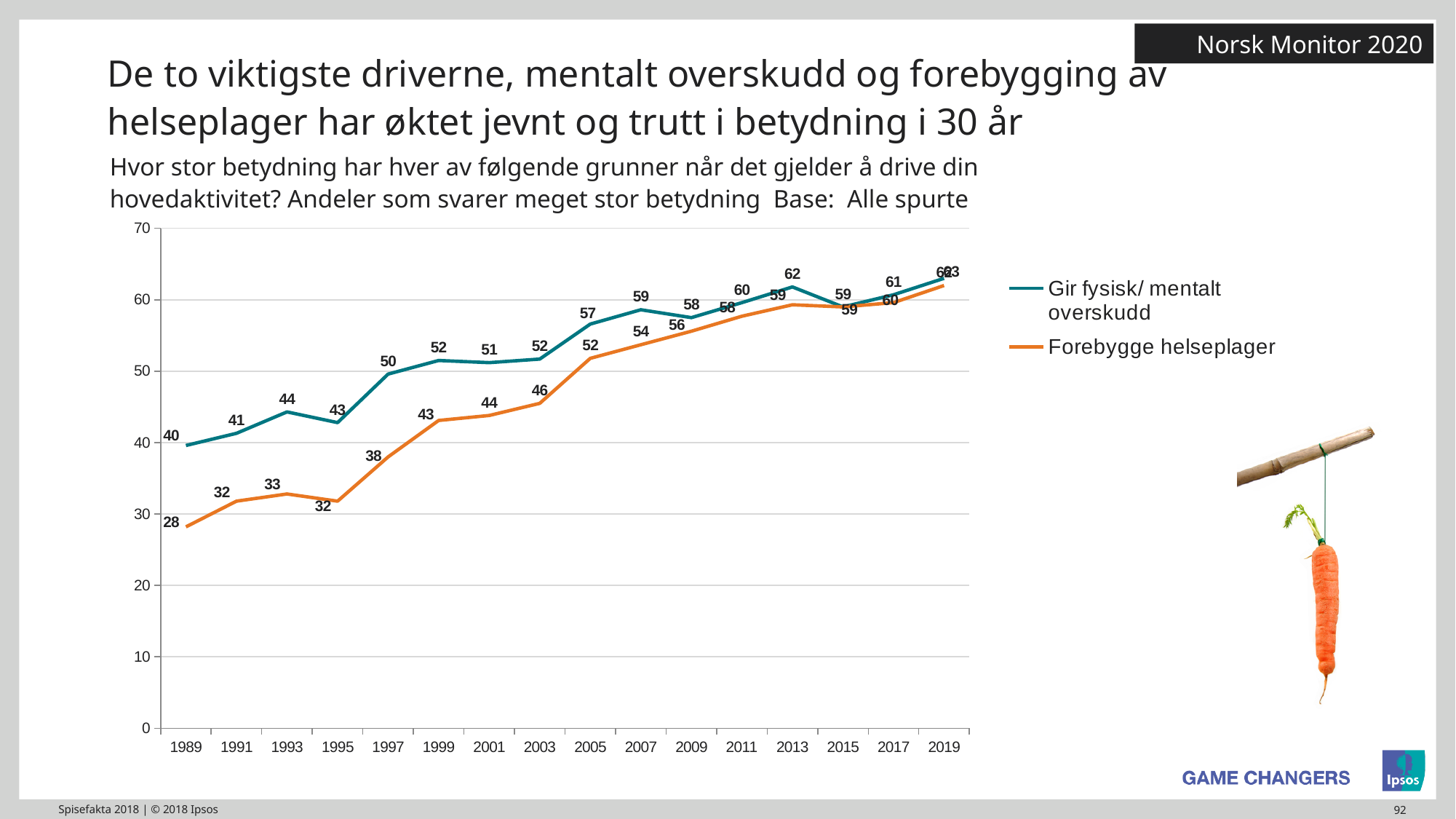
What is the value for Gir fysisk/ mentalt overskudd in 2013? 62 What kind of chart is shown on the slide? line chart What is the value for Forebygge helseplager in 1989? 28 In which year is the value for Gir fysisk/ mentalt overskudd highest? 2019 Which series has the higher value in 1997? Gir fysisk/ mentalt overskudd What is the difference between Gir fysisk/ mentalt overskudd and Forebygge helseplager in 1989? 12 Do the values for Forebygge helseplager generally rise or fall from 1989 to 2019? rise How many years are plotted on the x axis? 16 What is the value for Gir fysisk/ mentalt overskudd in 1989? 40 In which year is the value for Forebygge helseplager lowest? 1989 How many series does the legend list? 2 What is the value for Forebygge helseplager in 2005? 52